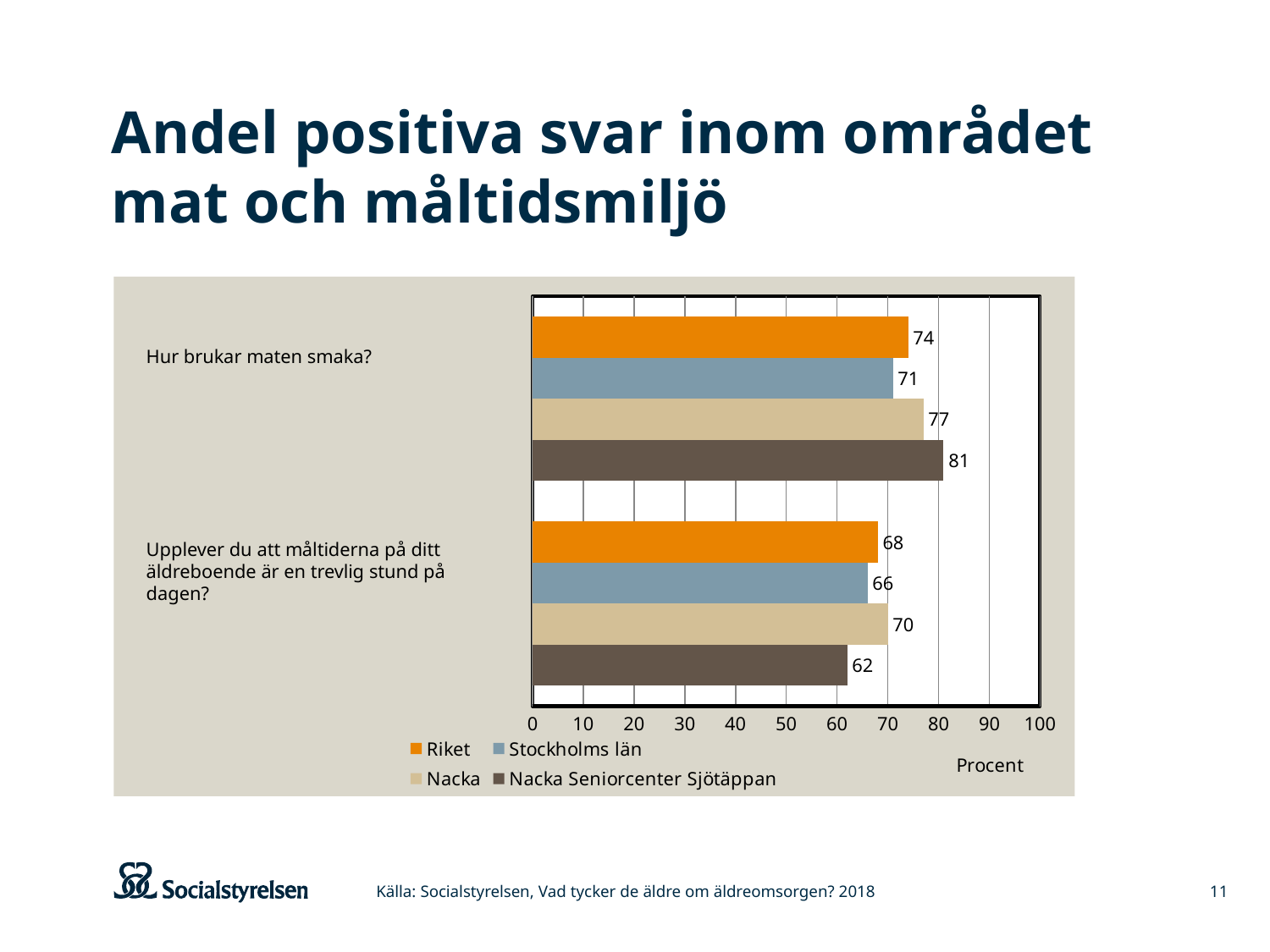
Which series has the highest value for "Hur brukar maten smaka?"? Nacka Seniorcenter Sjötäppan What is the value for Nacka Seniorcenter Sjötäppan for the question "Hur brukar maten smaka?"? 81 How many series does the legend list? 4 What is the difference between the Nacka Seniorcenter Sjötäppan values for the two questions? 19 For "Upplever du att måltiderna på ditt äldreboende är en trevlig stund på dagen?", which is larger: Nacka or Riket? Nacka How many questions (categories) are shown on the chart? 2 What is the value for Stockholms län for the question "Hur brukar maten smaka?"? 71 What is the value for Riket for the question "Upplever du att måltiderna på ditt äldreboende är en trevlig stund på dagen?"? 68 What kind of chart is shown on the slide? Bar chart What is the difference between the Nacka value and the Stockholms län value for "Hur brukar maten smaka?"? 6 What is the label on the horizontal axis of the chart? Procent Which series has the lowest value for "Upplever du att måltiderna på ditt äldreboende är en trevlig stund på dagen?"? Nacka Seniorcenter Sjötäppan